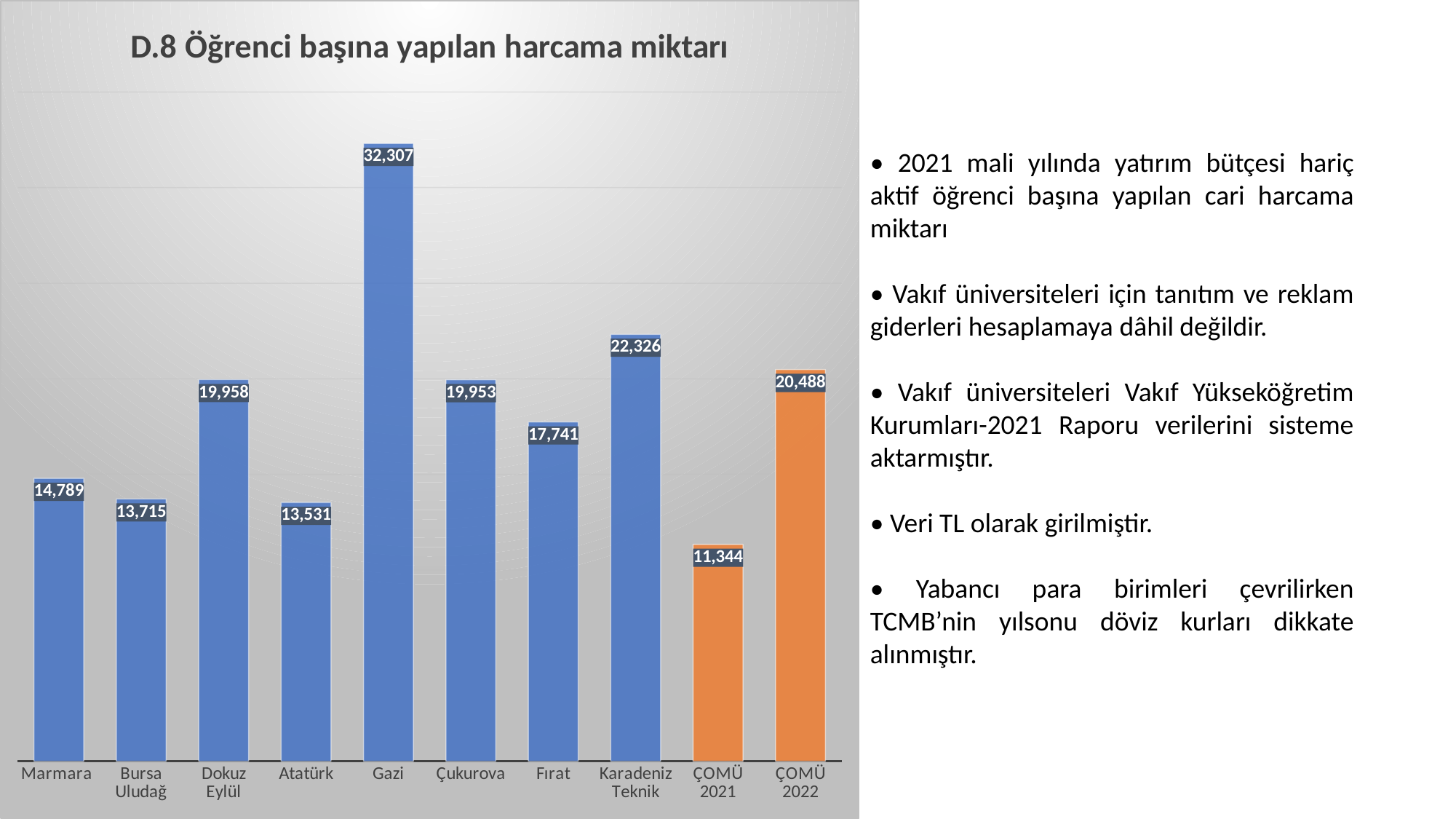
What kind of chart is shown on the slide? Bar chart Which is larger, the value for Marmara or the value for Bursa Uludağ? Marmara What is the value for Karadeniz Teknik? 22,326 What is the difference between the values for ÇOMÜ 2022 and ÇOMÜ 2021? 9,144 Which category has the lowest value? ÇOMÜ 2021 What is the difference between the values for Gazi and Karadeniz Teknik? 9,981 How many categories are shown in the chart? 10 What is the value for Fırat? 17,741 What is the value for ÇOMÜ 2021? 11,344 What is the title of the chart? D.8 Öğrenci başına yapılan harcama miktarı What is the value for Gazi? 32,307 Which category has the highest value? Gazi